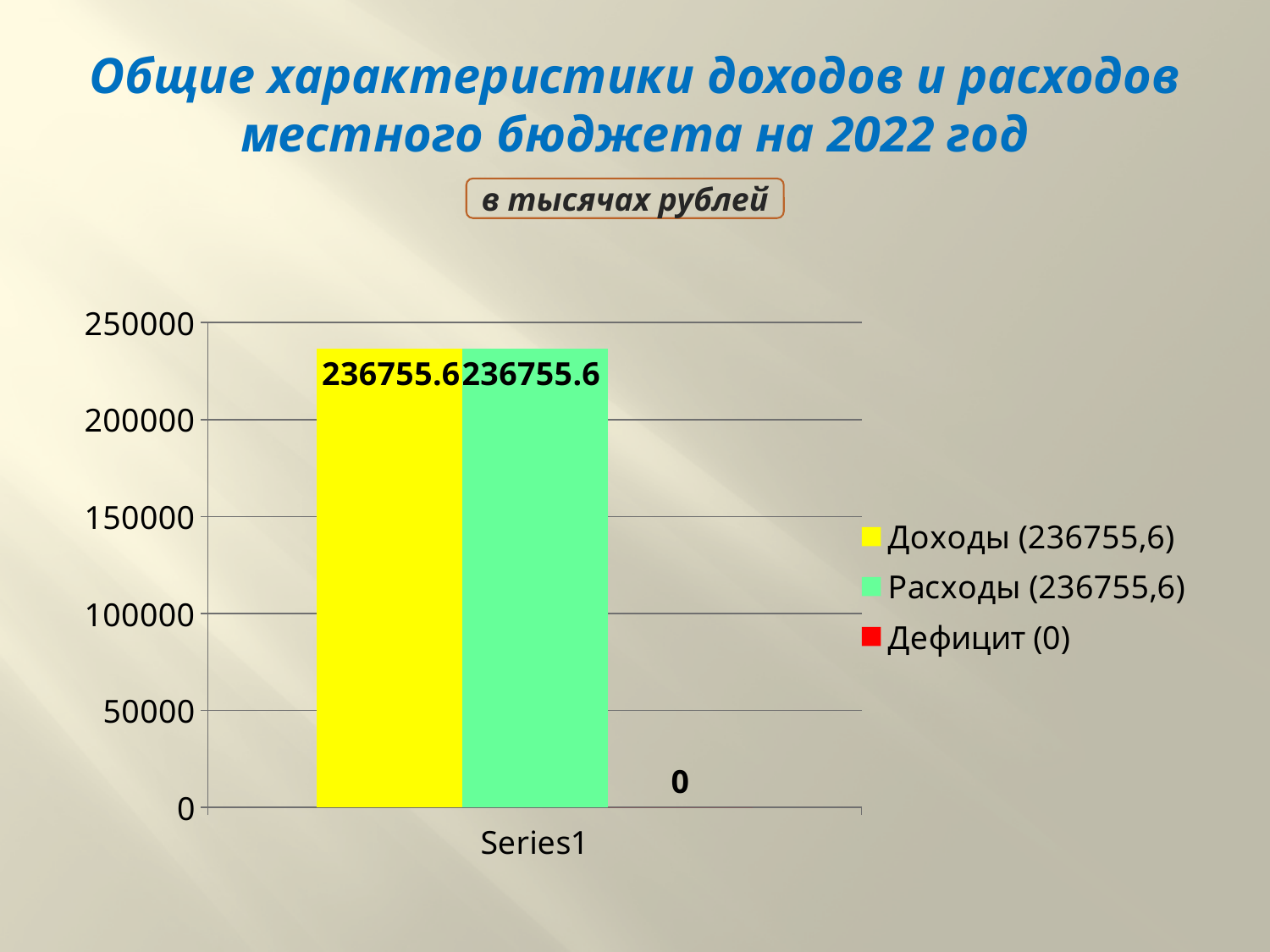
What is the value of the Расходы bar? 236755.6 What is the value shown for Дефицит? 0 What colour is the Доходы bar? yellow What is the value of the Доходы bar? 236755.6 What is the difference between the Доходы and Расходы values? 0 Is the value for Доходы greater or less than 200000? greater How many series does the legend list? 3 What is the difference between the Доходы value and the Дефицит value? 236755.6 What kind of chart is shown on the slide? bar chart What is the category label shown on the x axis? Series1 Is the value for Расходы greater or less than 250000? less Which series has the lowest value? Дефицит